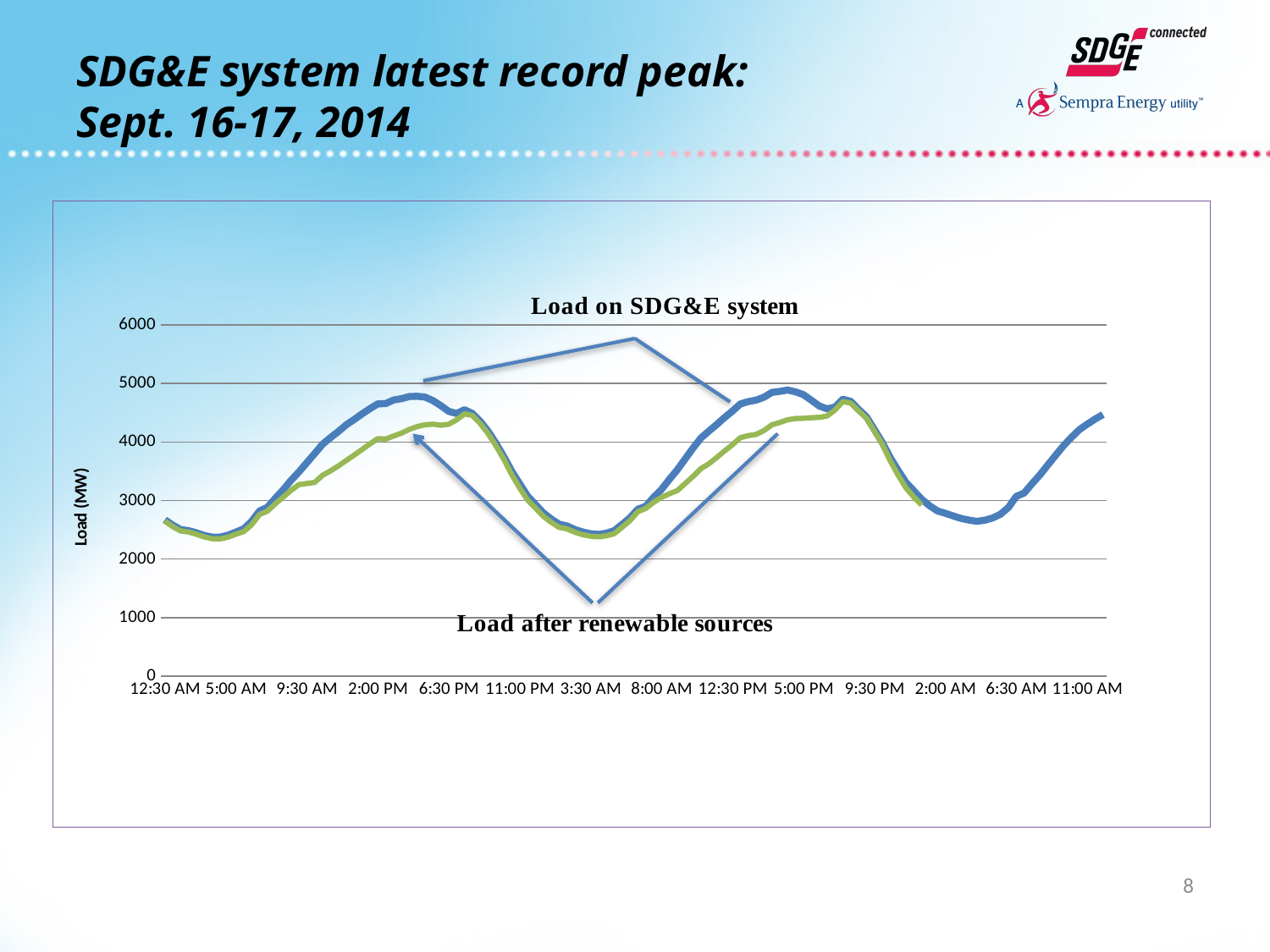
Is the highest value of the 'Load on SDG&E system' line greater or less than 4000? greater At 2:00 PM on the first day, which series has the higher value, 'Load on SDG&E system' or 'Load after renewable sources'? Load on SDG&E system Is the lowest value of the 'Load on SDG&E system' line greater or less than 3000? less What is the label on the vertical axis of the chart? Load (MW) Between 12:30 AM and 6:30 PM on the first day, does the 'Load on SDG&E system' line rise or fall? rise Is the value of 'Load on SDG&E system' at 5:00 PM greater or less than 4000? greater How many data series are plotted on the chart? 2 Which series is drawn in green? Load after renewable sources How many time labels are shown along the x axis? 14 What kind of chart is shown on the slide? Line chart Between 6:30 PM and 3:30 AM, does the 'Load after renewable sources' line rise or fall? fall